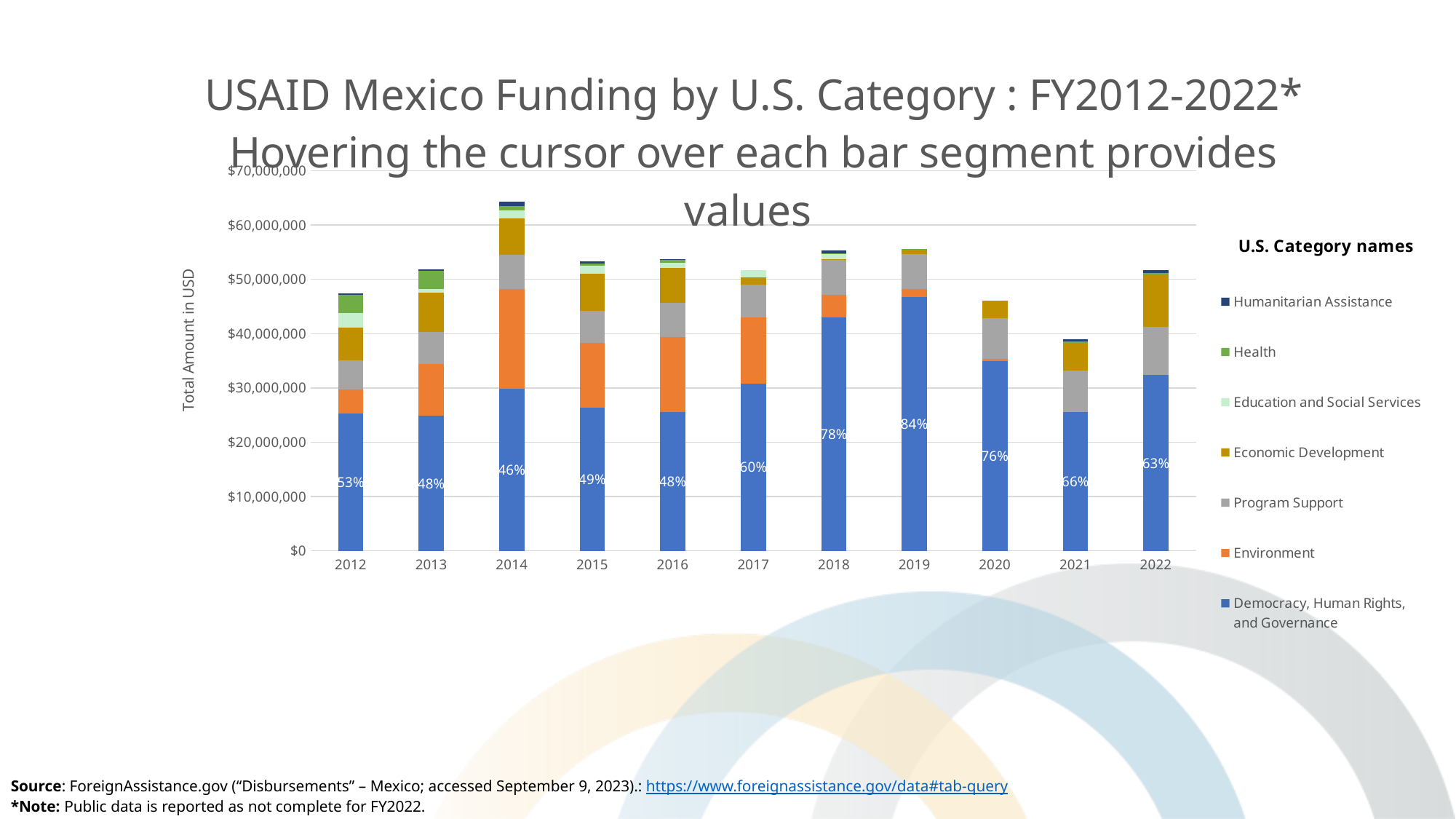
Is the total bar for 2014 greater or less than $60,000,000? greater What kind of chart is shown on the slide? Stacked bar chart Which year has the tallest total bar? 2014 Which year has the shortest total bar? 2021 Which year has the highest percentage label on the Democracy, Human Rights, and Governance segment? 2019 How many fiscal years are shown on the x axis? 11 What percentage label is shown on the Democracy, Human Rights, and Governance segment for 2014? 46% What percentage label is shown on the Democracy, Human Rights, and Governance segment for 2022? 63% Which year has the lowest percentage label on the Democracy, Human Rights, and Governance segment? 2014 How many series does the legend list? 7 What percentage label is shown on the Democracy, Human Rights, and Governance segment for 2019? 84%